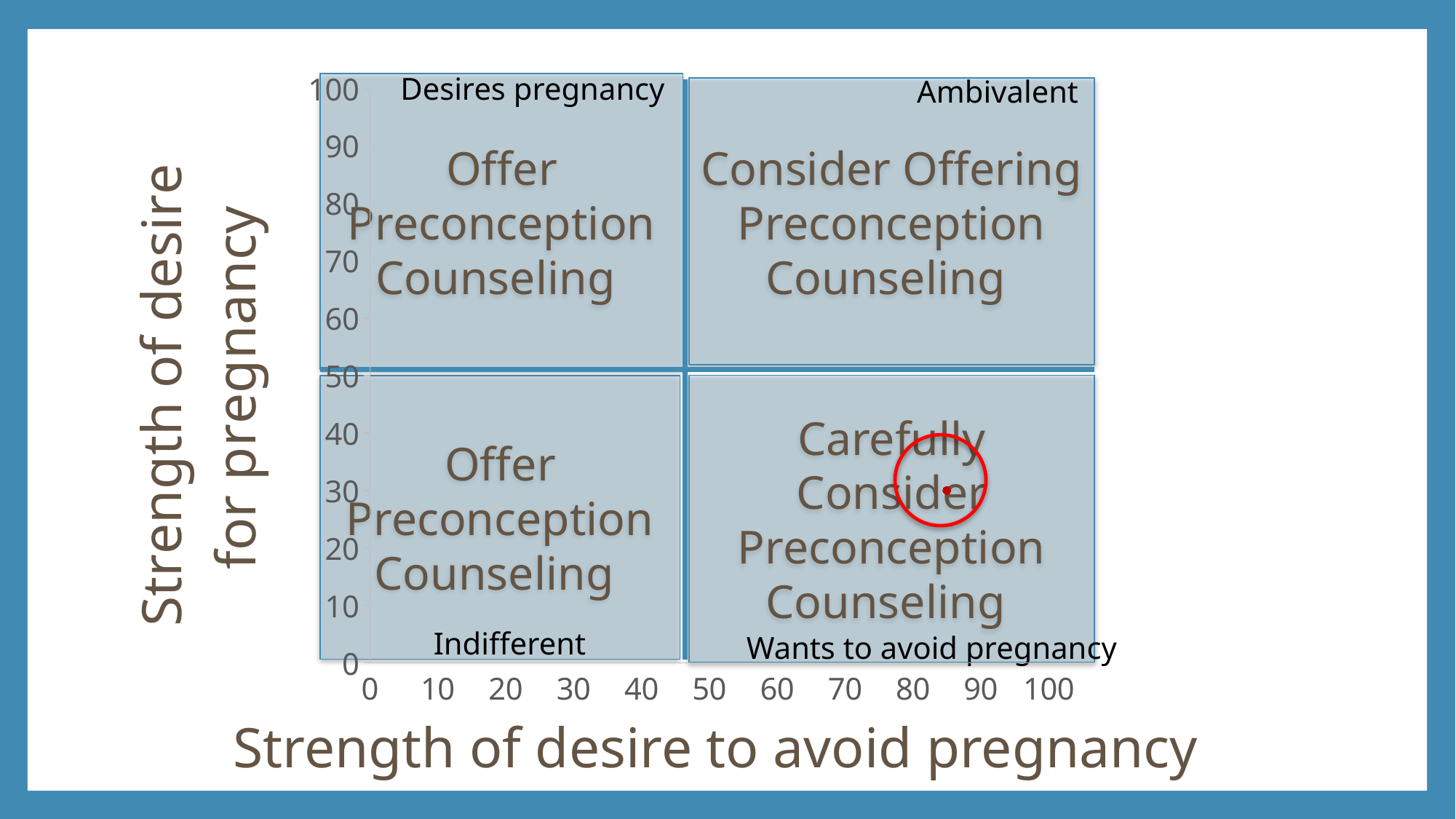
Is the plotted point's value on the y axis greater or less than 20? greater Is the plotted point's value on the y axis greater or less than 40? less Is the plotted point's value on the x axis greater or less than 70? greater How many data points are plotted on the chart? 1 Which quadrant does the plotted point fall in? Wants to avoid pregnancy What is the maximum value shown on the y axis? 100 What is the title of the x axis? Strength of desire to avoid pregnancy What kind of chart is shown on the slide? scatter chart